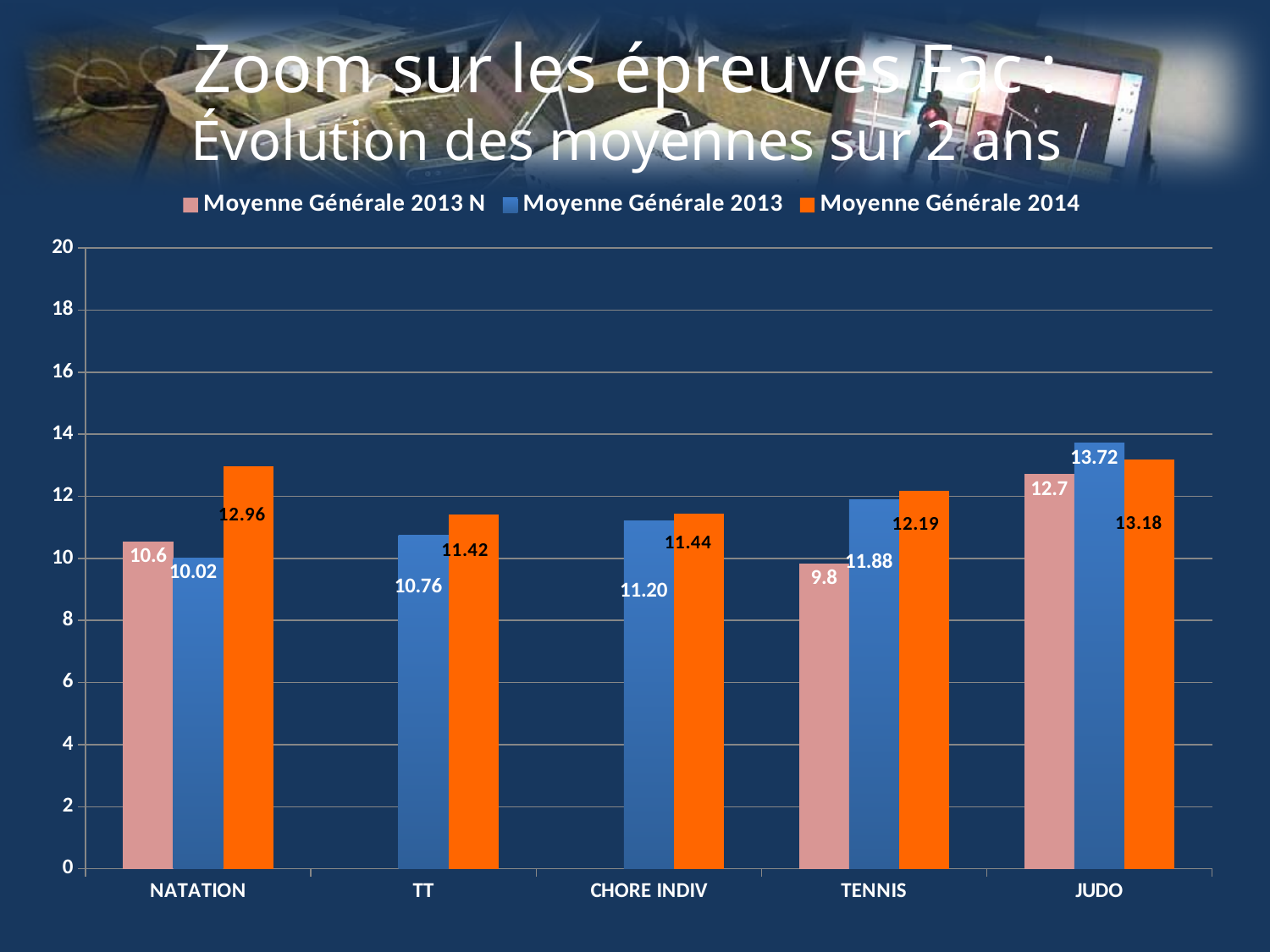
Is the Moyenne Générale 2014 value for TENNIS greater or less than 10? greater What is the Moyenne Générale 2014 value for NATATION? 12.96 What is the difference between the Moyenne Générale 2014 and Moyenne Générale 2013 values for NATATION? 2.94 For JUDO, which is larger: Moyenne Générale 2013 or Moyenne Générale 2014? Moyenne Générale 2013 How many categories are shown on the x axis? 5 Which category has the lowest Moyenne Générale 2013 value? NATATION What is the Moyenne Générale 2013 value for JUDO? 13.72 How many series does the legend list? 3 Which category has the highest Moyenne Générale 2014 value? JUDO What kind of chart is shown on the slide? bar chart What is the Moyenne Générale 2013 N value for TENNIS? 9.8 What is the Moyenne Générale 2013 value for TT? 10.76